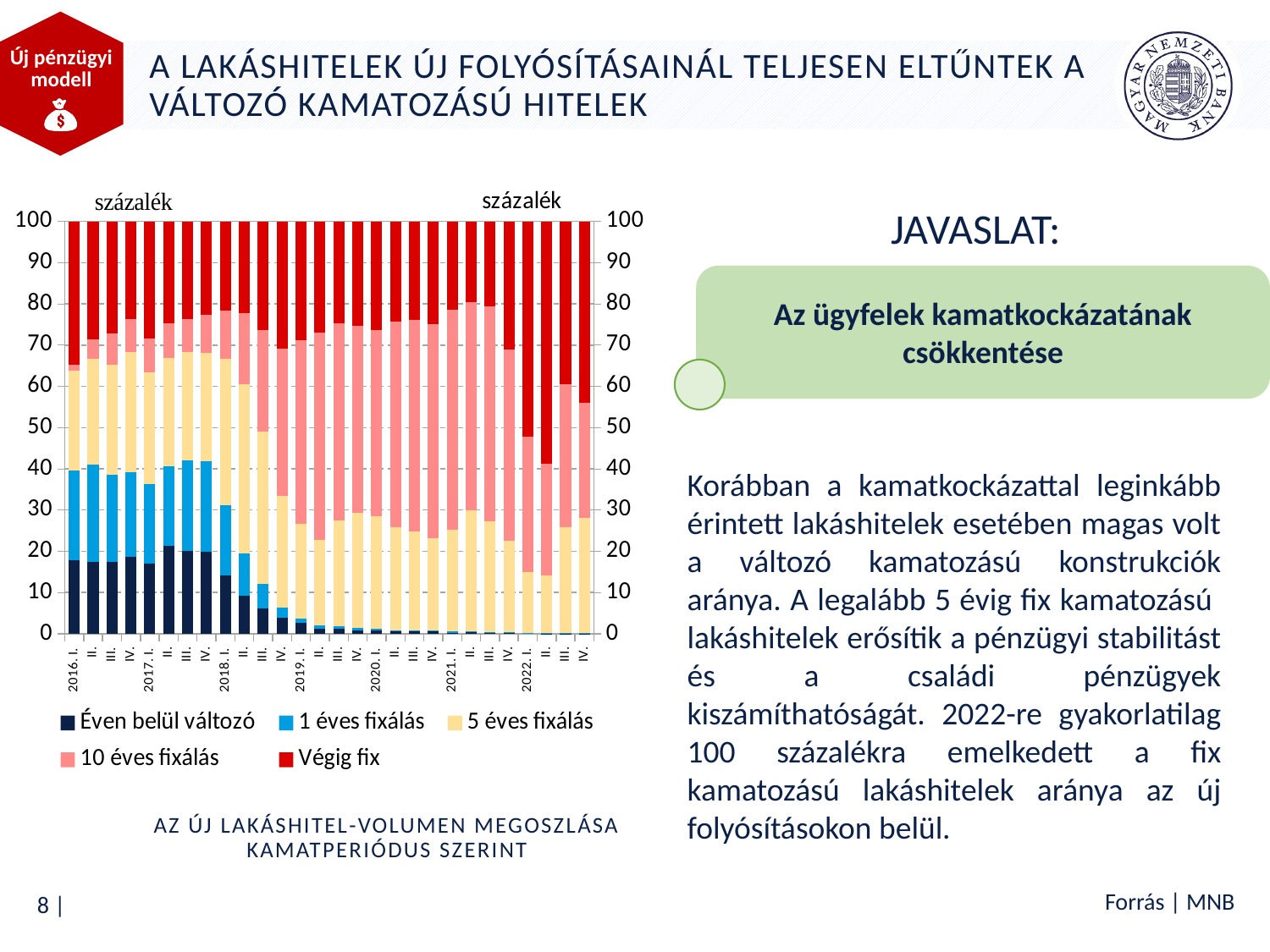
Is the 'Éven belül változó' share in 2016 I. greater or less than 10? greater Which is larger: the 'Végig fix' share in 2022 IV. or in 2016 I.? 2022 IV. What unit is shown on the vertical axes of the chart? százalék What kind of chart is shown on the slide? Stacked bar chart Does the share of 'Végig fix' loans rise or fall overall from 2016 to 2022 along the x axis? Rise Which is larger: the 'Éven belül változó' share in 2016 I. or in 2022 IV.? 2016 I. Is the 'Éven belül változó' share in 2020 I. greater or less than 10? less What is the total height of each stacked bar in the chart, as read from the axis? 100 How many quarterly bars are plotted in the chart (from 2016 I. to 2022 IV.)? 28 What is the title printed below the chart? AZ ÚJ LAKÁSHITEL-VOLUMEN MEGOSZLÁSA KAMATPERIÓDUS SZERINT How many series does the legend of the chart list? 5 Does the share of 'Éven belül változó' loans rise or fall from 2016 to 2022 along the x axis? Fall